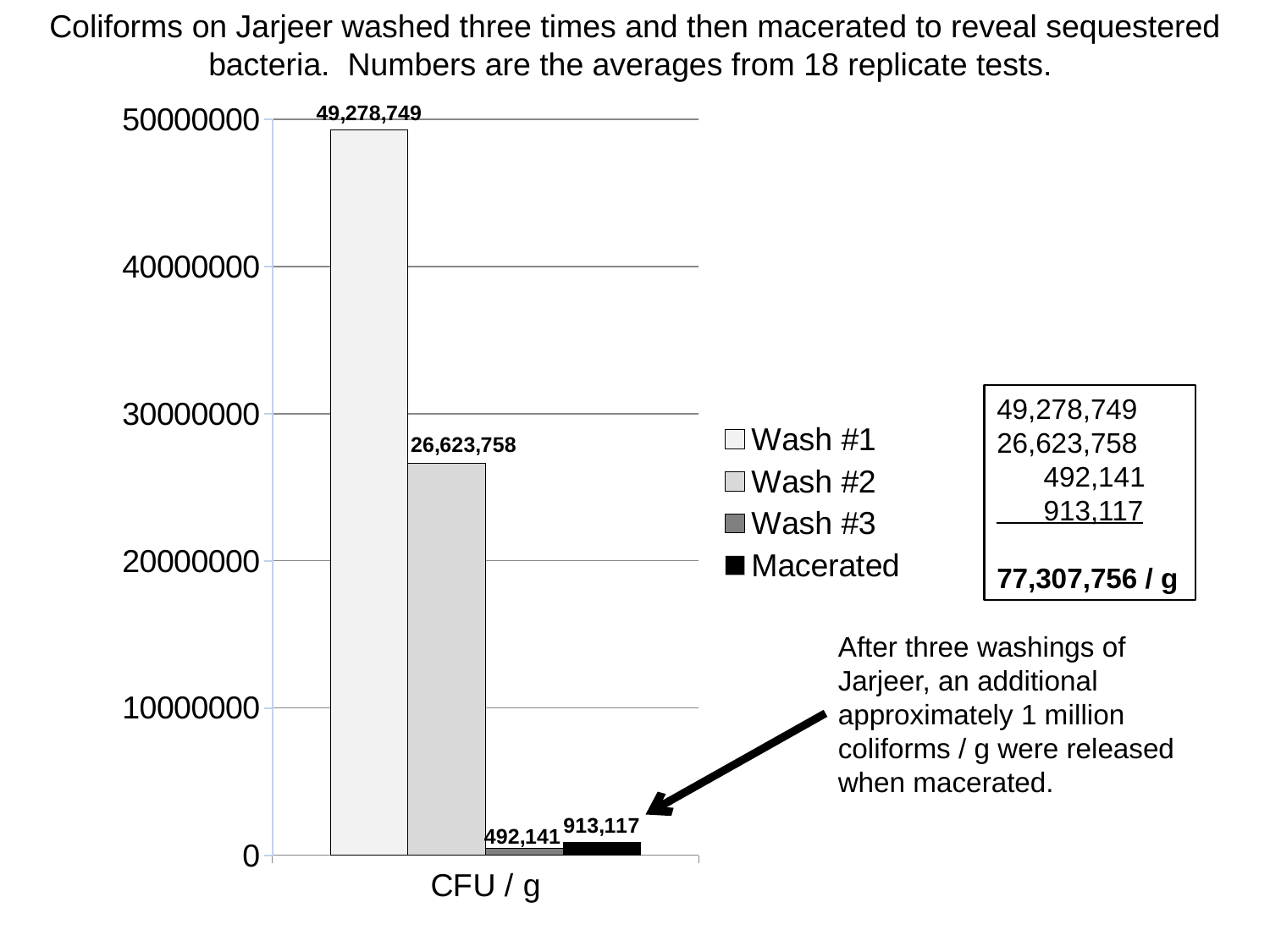
Which is larger, the value for Wash #3 or the value for Macerated? Macerated Which series has the lowest value? Wash #3 What is the difference between the Wash #1 and Wash #2 values? 22,654,991 How many series does the legend list? 4 What is the value for Wash #3? 492,141 Which series has the highest value? Wash #1 What is the value for Wash #1? 49,278,749 What kind of chart is shown on the slide? bar chart What is the value for Macerated? 913,117 What is the label on the x axis of the chart? CFU / g What is the value for Wash #2? 26,623,758 Is the value for Wash #2 greater or less than 30000000? less